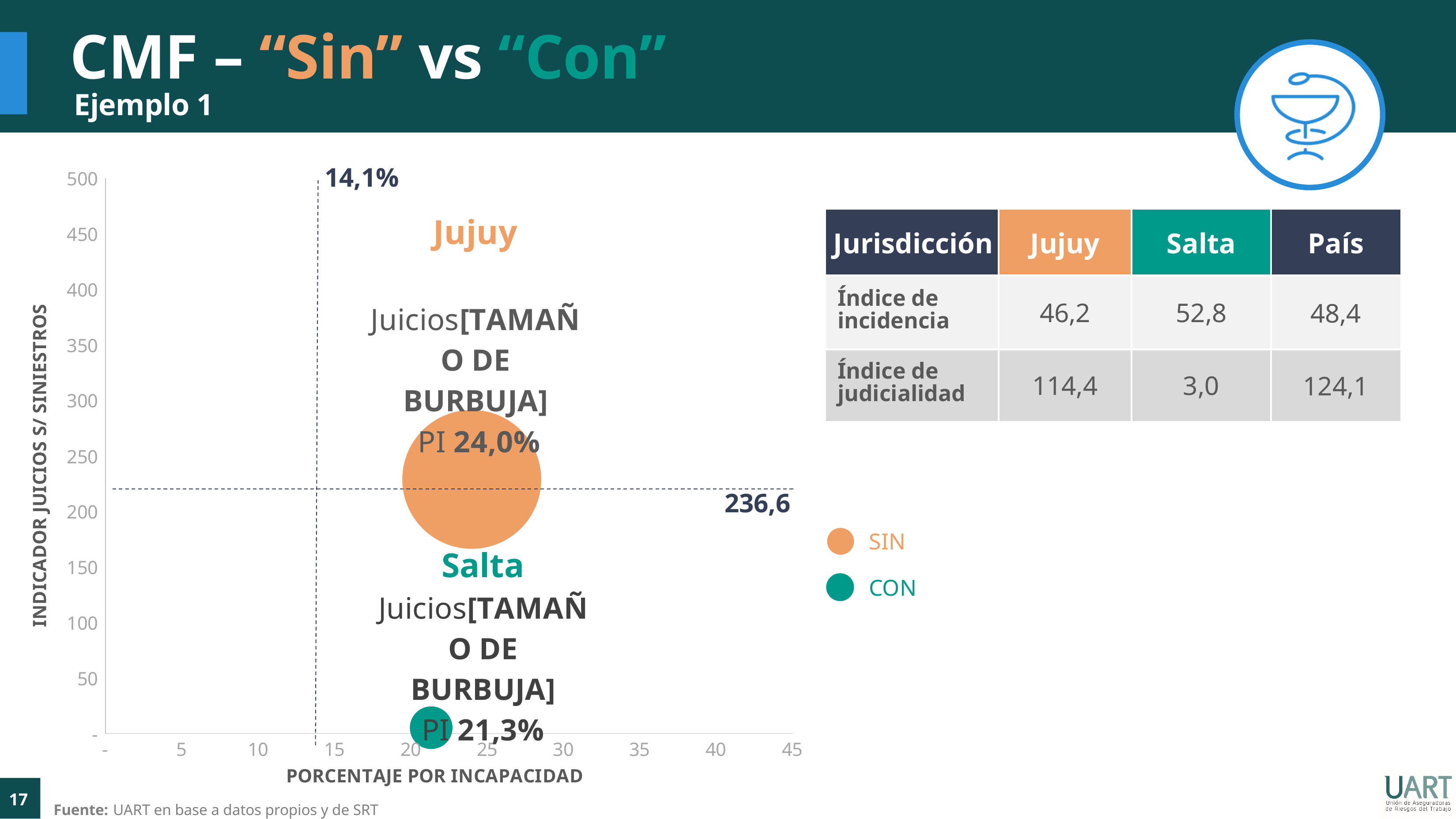
Is the Salta bubble's value on the vertical axis greater or less than 50? less How many series does the chart legend list? 2 What is the difference between the PI values of Jujuy and Salta? 2,7 percentage points Which bubble sits higher on the 'Indicador juicios s/ siniestros' axis, Jujuy or Salta? Jujuy Which jurisdiction has the higher PI value on the chart, Jujuy or Salta? Jujuy What PI value is labelled on the Jujuy bubble? 24,0% What is the title of the chart's horizontal axis? PORCENTAJE POR INCAPACIDAD What PI value is labelled on the Salta bubble? 21,3% How many bubbles are plotted on the chart? 2 Is the Jujuy bubble's value on the vertical axis greater or less than 200? greater What value is labelled on the horizontal dashed reference line of the chart? 236,6 What kind of chart is shown on the left of the slide? bubble chart